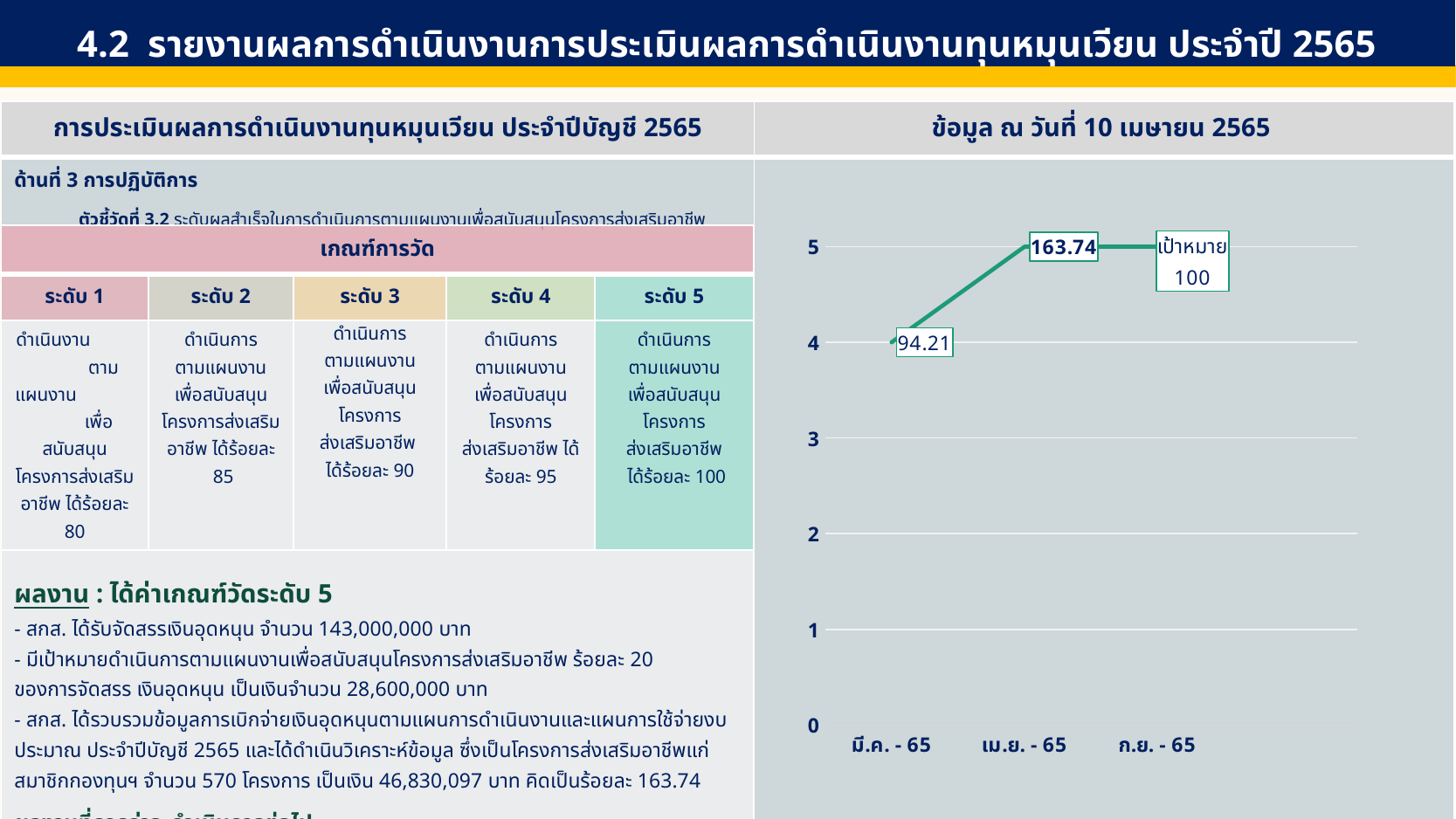
How many categories are shown on the x axis of the line chart? 3 What kind of chart is shown on the right side of the slide? line chart Which x-axis category has the lowest labelled value on the line chart? มี.ค. - 65 What data label is shown for มี.ค. - 65 on the line chart? 94.21 What target value (เป้าหมาย) is labelled at ก.ย. - 65 on the line chart? 100 Does the line rise or fall from มี.ค. - 65 to เม.ย. - 65? rises Which x-axis category has the highest labelled value on the line chart? เม.ย. - 65 What is the difference between the labelled values for เม.ย. - 65 and มี.ค. - 65 on the line chart? 69.53 On which y-axis level does the point for มี.ค. - 65 sit on the line chart? 4 Which is larger on the line chart, the value for มี.ค. - 65 or the value for เม.ย. - 65? เม.ย. - 65 What colour is the line in the chart? green What data label is shown for เม.ย. - 65 on the line chart? 163.74